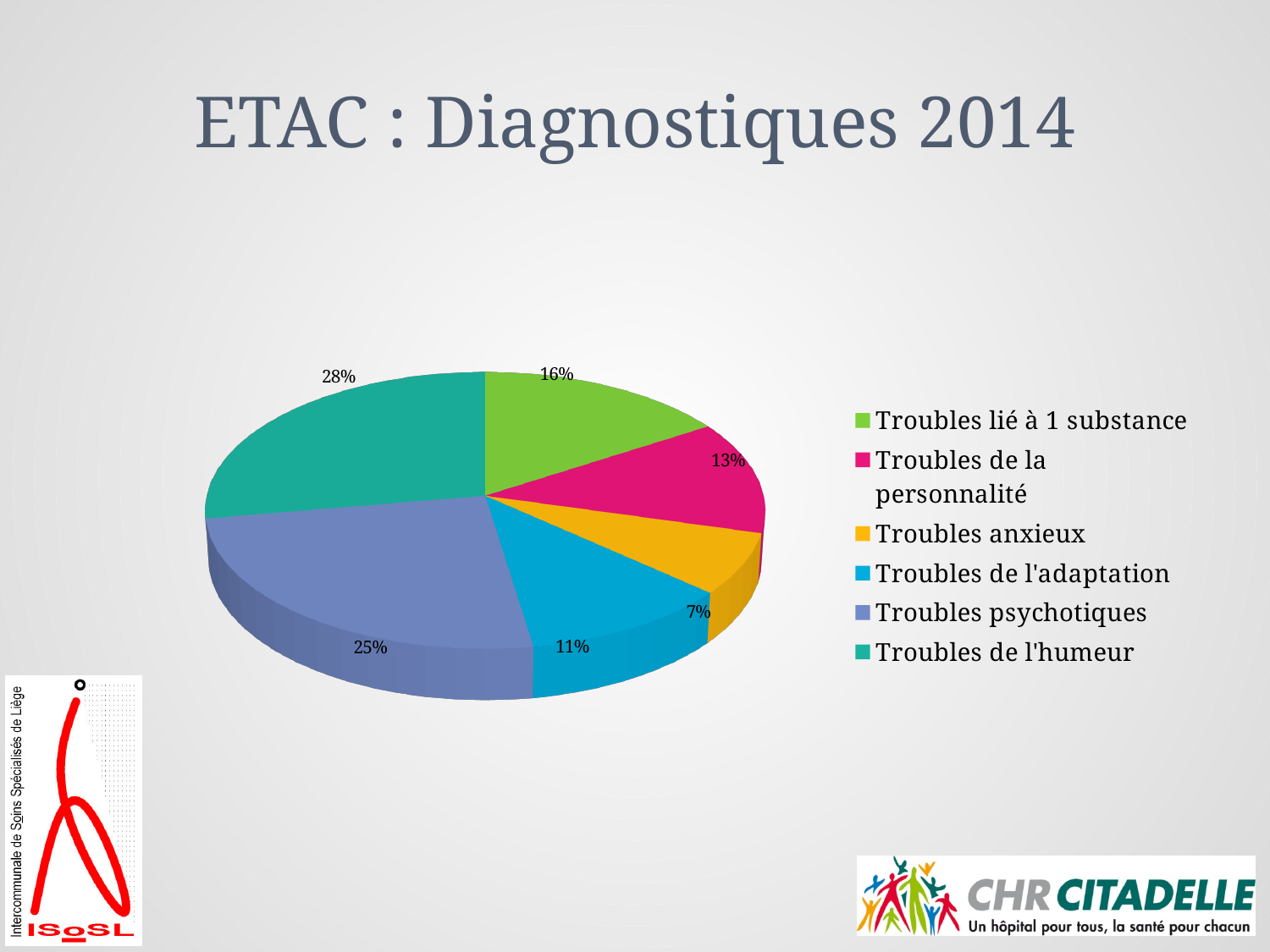
Which category has the largest slice of the pie? Troubles de l'humeur What share of the pie is Troubles lié à 1 substance? 16% What is the title of the slide containing the chart? ETAC : Diagnostiques 2014 What is the difference in percentage points between Troubles de l'humeur and Troubles de la personnalité? 15% What share of the pie is Troubles anxieux? 7% What kind of chart is shown on the slide? Pie chart Which is larger, Troubles de l'adaptation or Troubles de la personnalité? Troubles de la personnalité What share of the pie is Troubles psychotiques? 25% How many categories does the legend list? 6 Which category has the smallest slice of the pie? Troubles anxieux